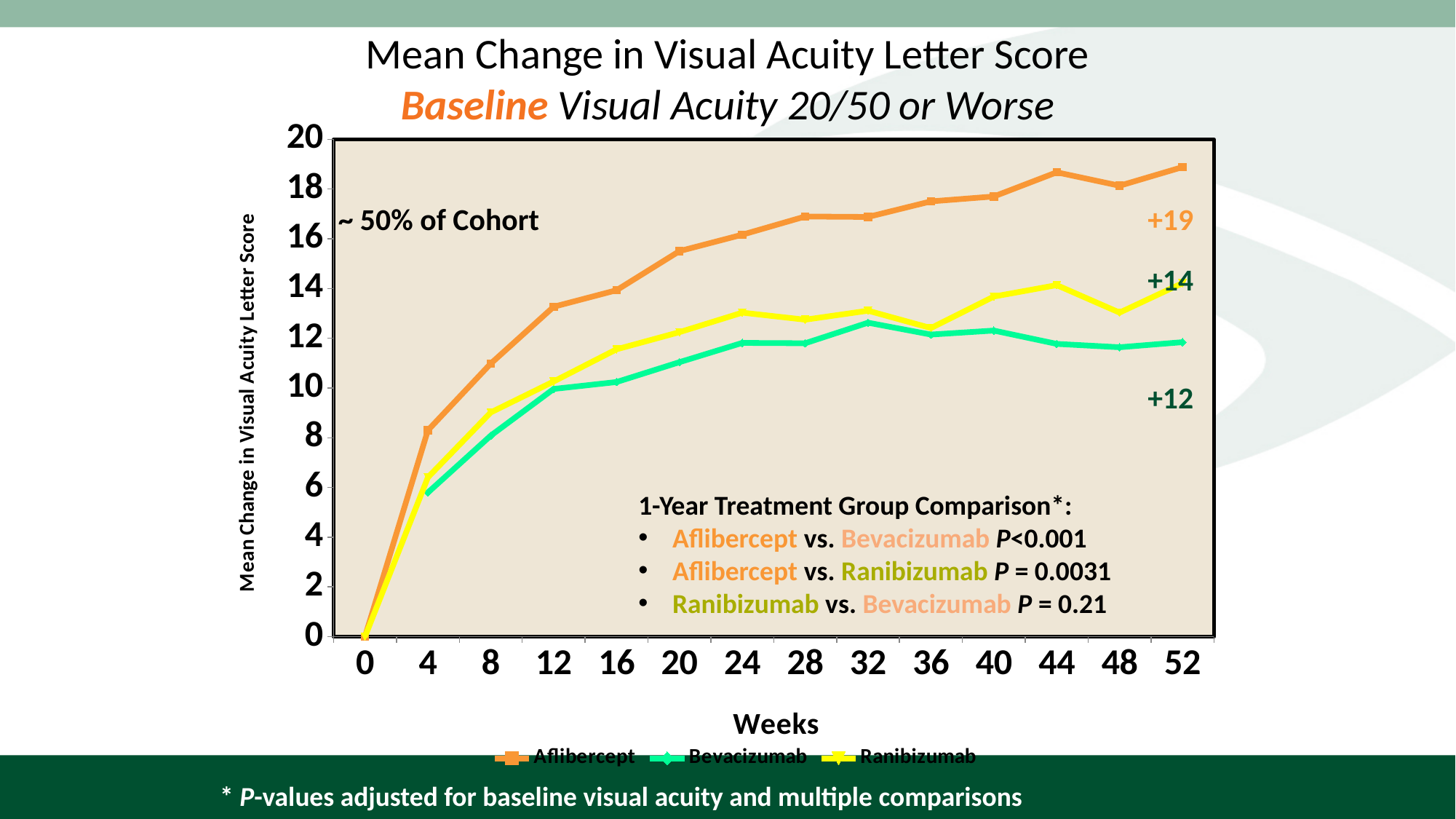
Which treatment group has the lowest mean change at week 52? Bevacizumab Which treatment group has the highest mean change at week 52? Aflibercept What is the labelled mean change at week 52 for Aflibercept? +19 Does the Aflibercept line generally rise or fall from week 0 to week 52? rise What is the difference between the labelled week-52 values for Aflibercept and Bevacizumab? 7 What is the labelled mean change at week 52 for Bevacizumab? +12 How many series does the legend list? 3 How many week points are marked along the x axis? 14 What kind of chart is shown on the slide? line chart At week 44, which is higher: Ranibizumab or Bevacizumab? Ranibizumab What is the labelled mean change at week 52 for Ranibizumab? +14 Is the value for Aflibercept at week 20 greater or less than 14? greater